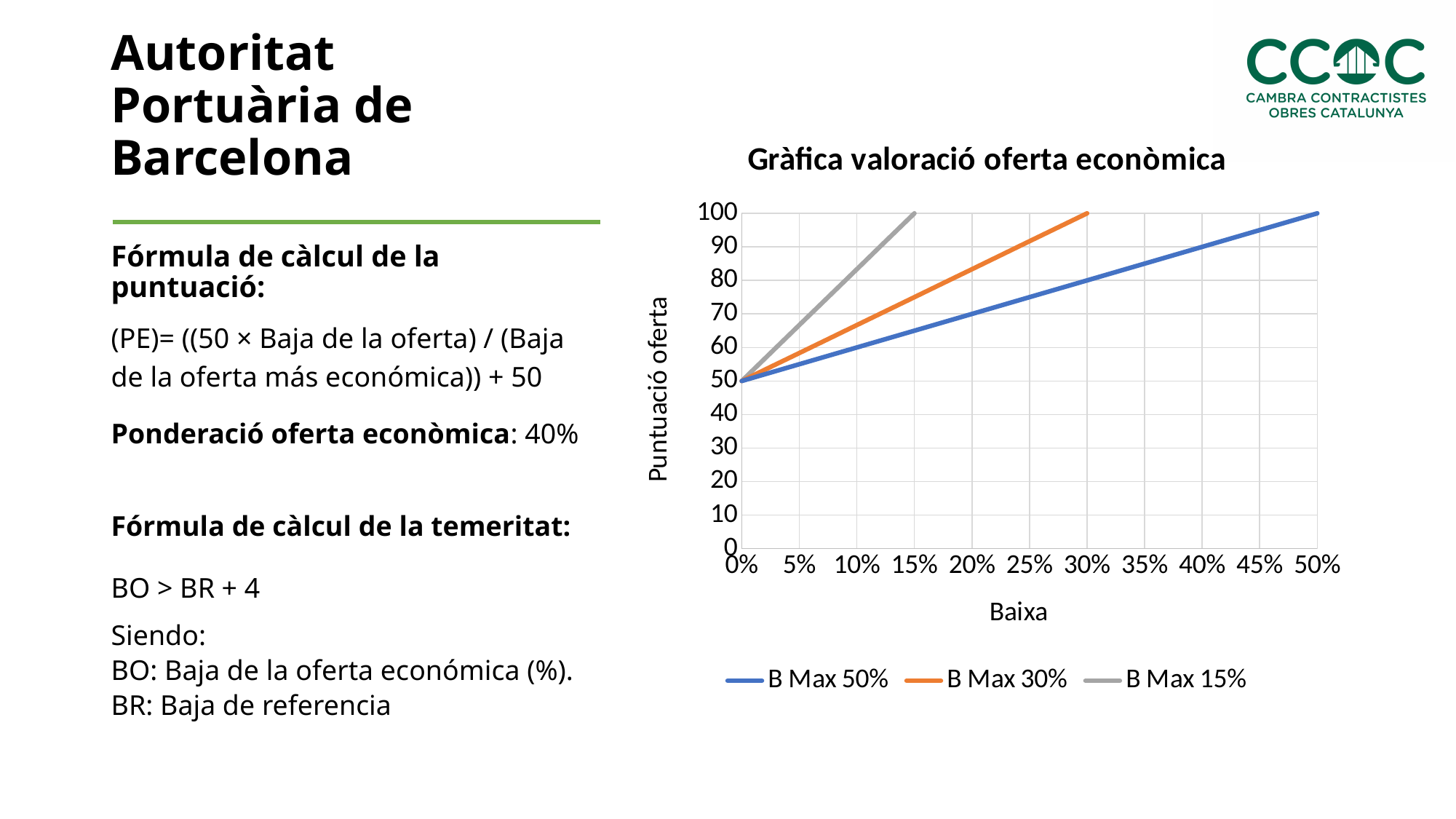
What is the label of the y axis of the chart? Puntuació oferta What is the value of the B Max 30% series at a Baixa of 30%? 100 Do the values of the B Max 50% series rise or fall as Baixa increases? rise What is the value of the B Max 15% series at a Baixa of 15%? 100 What is the value of the B Max 50% series at a Baixa of 0%? 50 At a Baixa of 10%, which series has the higher value, B Max 15% or B Max 50%? B Max 15% Is the value of the B Max 50% series at a Baixa of 25% greater or less than 80? less What kind of chart is shown on the slide? line chart How many series does the chart legend list? 3 Is the value of the B Max 30% series at a Baixa of 20% greater or less than 80? greater What is the title of the chart? Gràfica valoració oferta econòmica What is the value of the B Max 50% series at a Baixa of 50%? 100